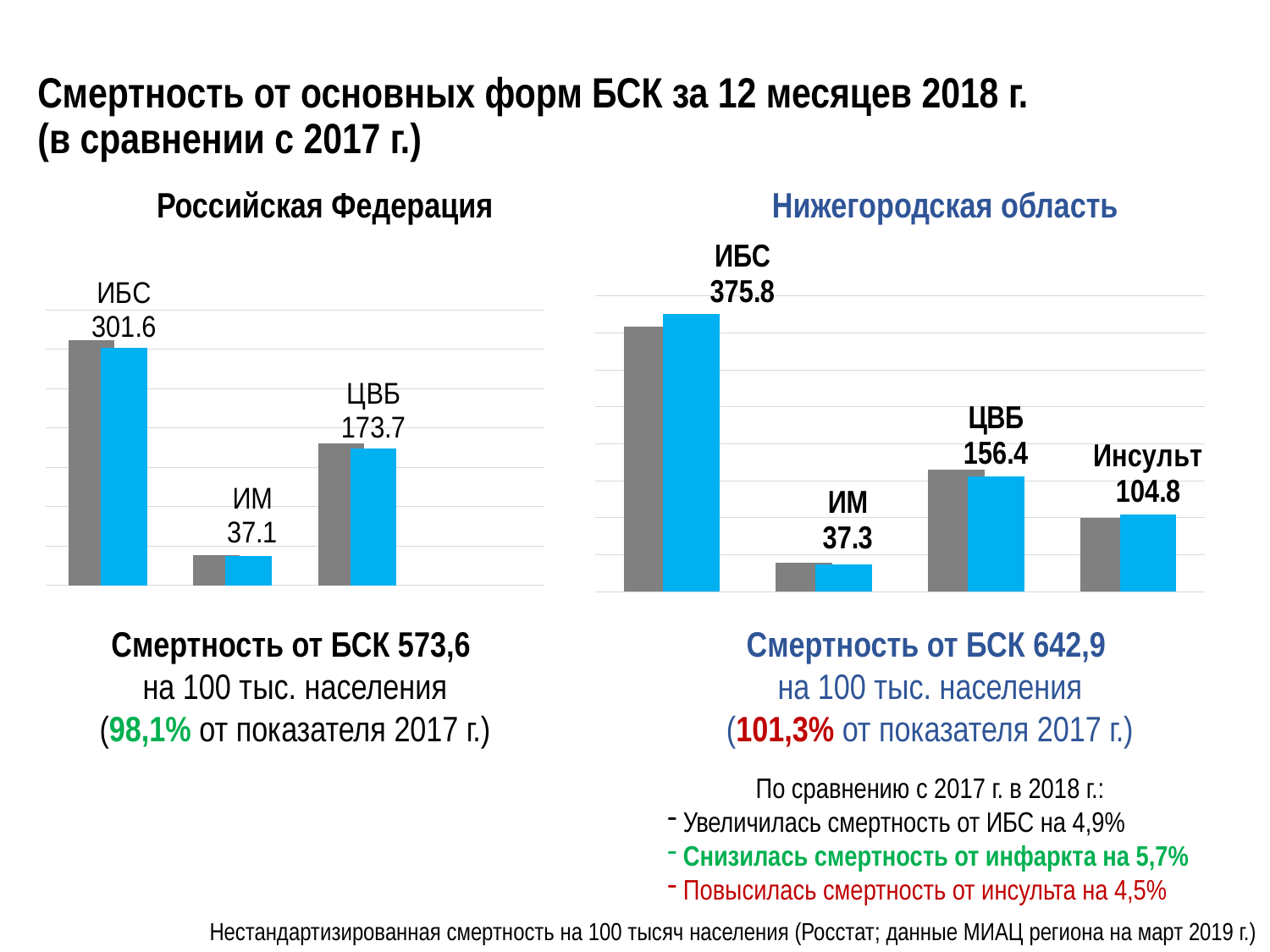
In the Нижегородская область chart, what is the difference between the labelled values for ЦВБ and Инсульт? 51.6 In the Российская Федерация chart, what value is labelled for ИБС? 301.6 In the Российская Федерация chart, which category has the lowest value? ИМ In the Российская Федерация chart, what is the difference between the labelled values for ИБС and ЦВБ? 127.9 How many categories are shown in the Нижегородская область chart? 4 In the Нижегородская область chart, what value is labelled for ЦВБ? 156.4 In the Нижегородская область chart, what value is labelled for Инсульт? 104.8 In the Нижегородская область chart, which category has the highest value? ИБС Which chart shows the larger labelled value for ИБС, Российская Федерация or Нижегородская область? Нижегородская область How many categories are shown in the Российская Федерация chart? 3 What kind of chart is used for the Российская Федерация data? bar chart In the Российская Федерация chart, what value is labelled for ИМ? 37.1